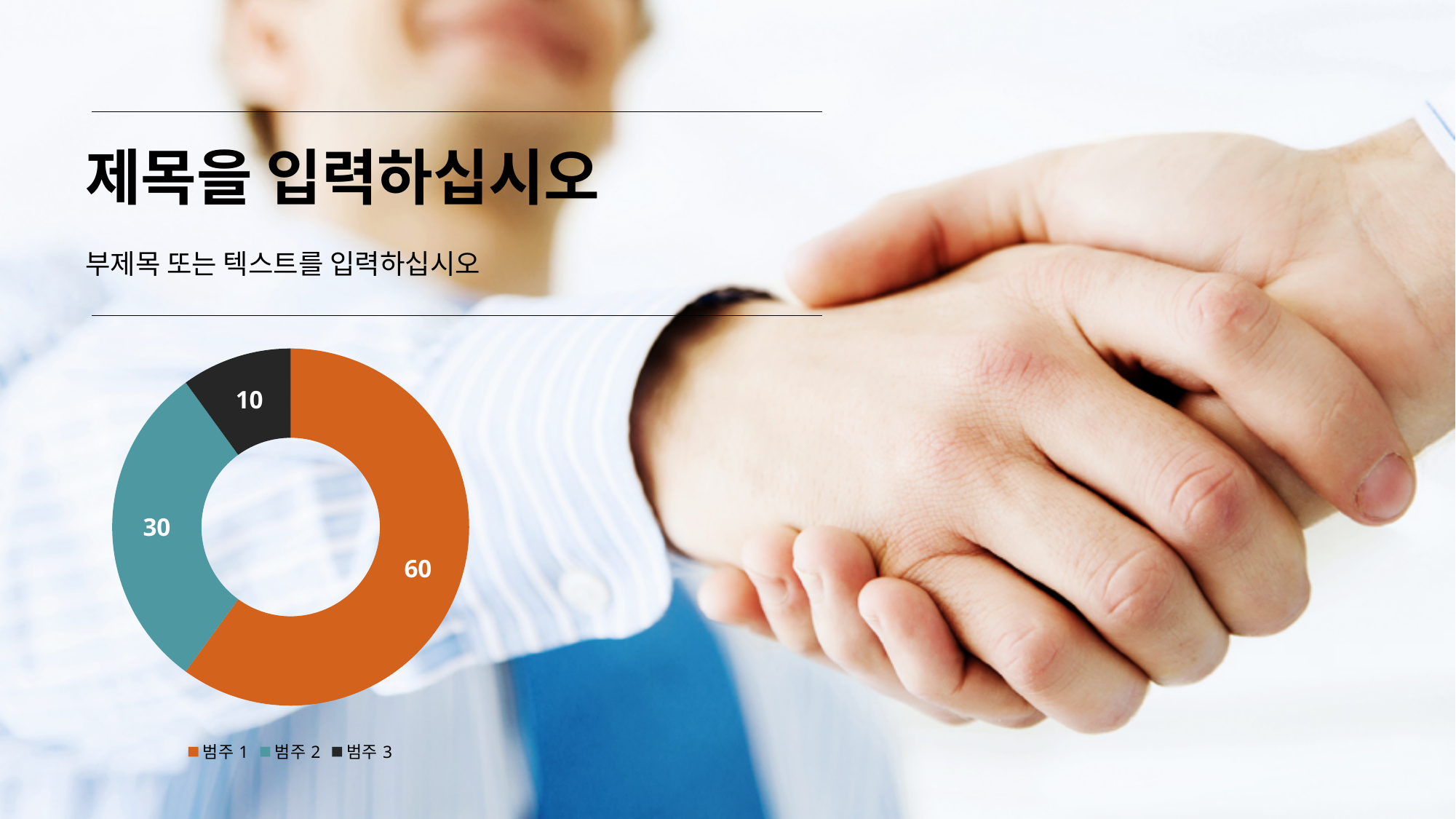
What is the difference between the values for 범주 1 and 범주 2? 30 Which is larger, the value for 범주 2 or the value for 범주 3? 범주 2 How many categories does the chart show? 3 What colour is the slice for 범주 2? Teal What share of the total does 범주 1 represent? 60% What is the value for 범주 3? 10 Which category has the smallest value? 범주 3 What is the value for 범주 1? 60 Which category has the largest value? 범주 1 What kind of chart is shown on the slide? Doughnut chart What is the total of all the values in the chart? 100 What is the value for 범주 2? 30